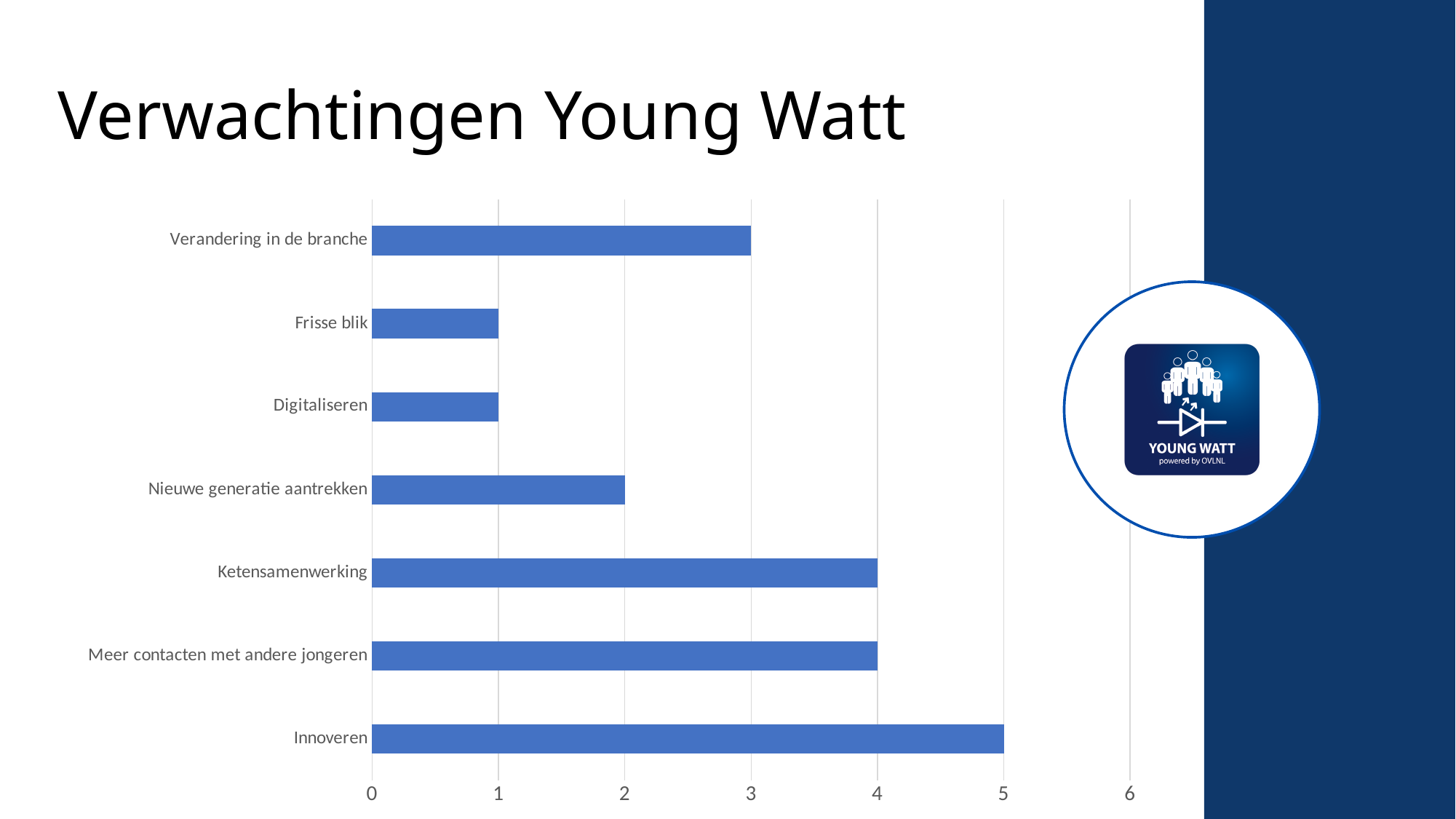
What is the difference between the values for Ketensamenwerking and Nieuwe generatie aantrekken? 2 What kind of chart is shown on the slide? bar chart What is the value for Ketensamenwerking? 4 What is the value for Verandering in de branche? 3 Which category has the highest value? Innoveren What is the value for Innoveren? 5 What is the difference between the values for Innoveren and Frisse blik? 4 How many categories are plotted in the chart? 7 Which is larger, the value for Verandering in de branche or the value for Digitaliseren? Verandering in de branche Is the value for Meer contacten met andere jongeren greater or less than 3? greater What is the value for Nieuwe generatie aantrekken? 2 What is the title of the slide containing the chart? Verwachtingen Young Watt